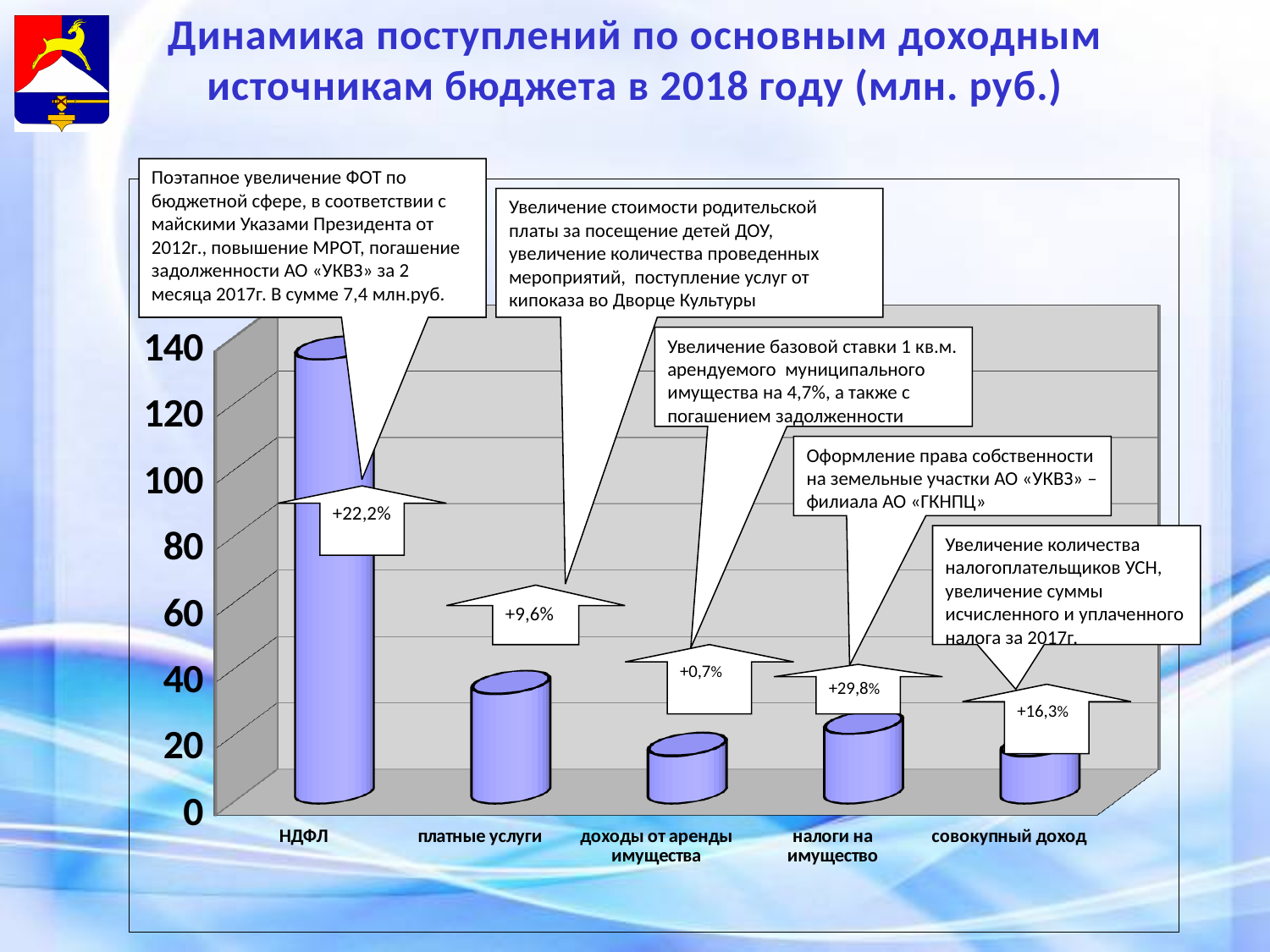
Is the value for доходы от аренды имущества greater or less than 40? less What growth percentage is shown in the arrow above the налоги на имущество bar? +29,8% How many categories are shown on the x axis of the chart? 5 Which category has the highest bar in the chart? НДФЛ Is the value for НДФЛ greater or less than 100? greater What growth percentage is shown in the arrow above the НДФЛ bar? +22,2% What is the title of the chart on the slide? Динамика поступлений по основным доходным источникам бюджета в 2018 году (млн. руб.) Which is larger, the value for НДФЛ or the value for платные услуги? НДФЛ Is the value for платные услуги greater or less than 60? less Which is larger, the value for платные услуги or the value for налоги на имущество? платные услуги What kind of chart is shown on the slide? bar chart